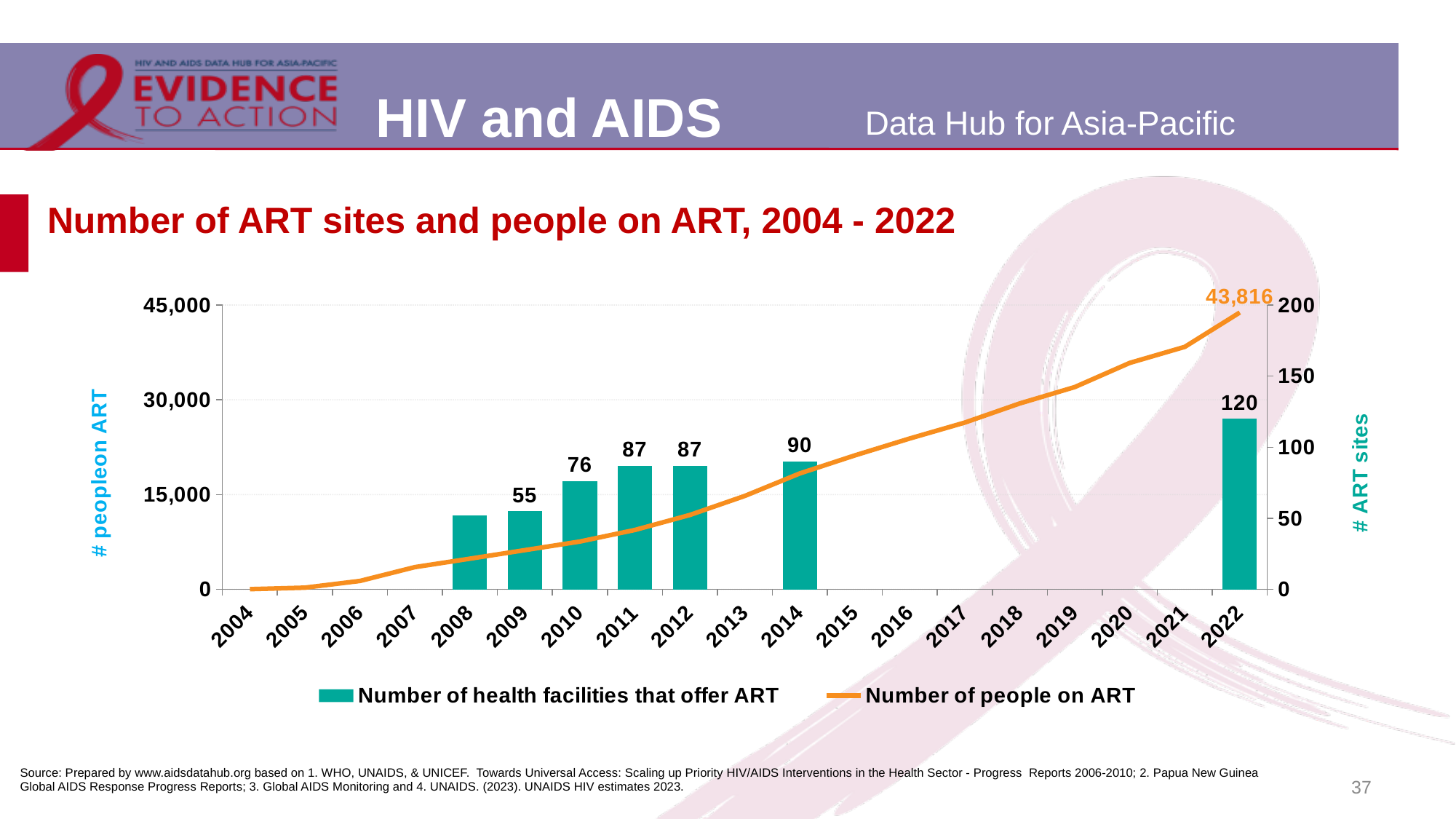
What is the number of health facilities that offer ART in 2022? 120 Which is larger, the number of health facilities that offer ART in 2011 or in 2009? 2011 What is the difference in the number of health facilities that offer ART between 2022 and 2014? 30 What is the difference in the number of health facilities that offer ART between 2010 and 2009? 21 How many health facilities offered ART in 2014? 90 Does the number of people on ART rise or fall from 2004 to 2022? rise Is the number of health facilities that offer ART in 2008 greater or less than 100? less What is the number of people on ART in 2022? 43,816 How many health facilities offered ART in 2010? 76 How many series does the legend list? 2 Which year has the highest number of health facilities that offer ART? 2022 What is the title of the chart? Number of ART sites and people on ART, 2004 - 2022